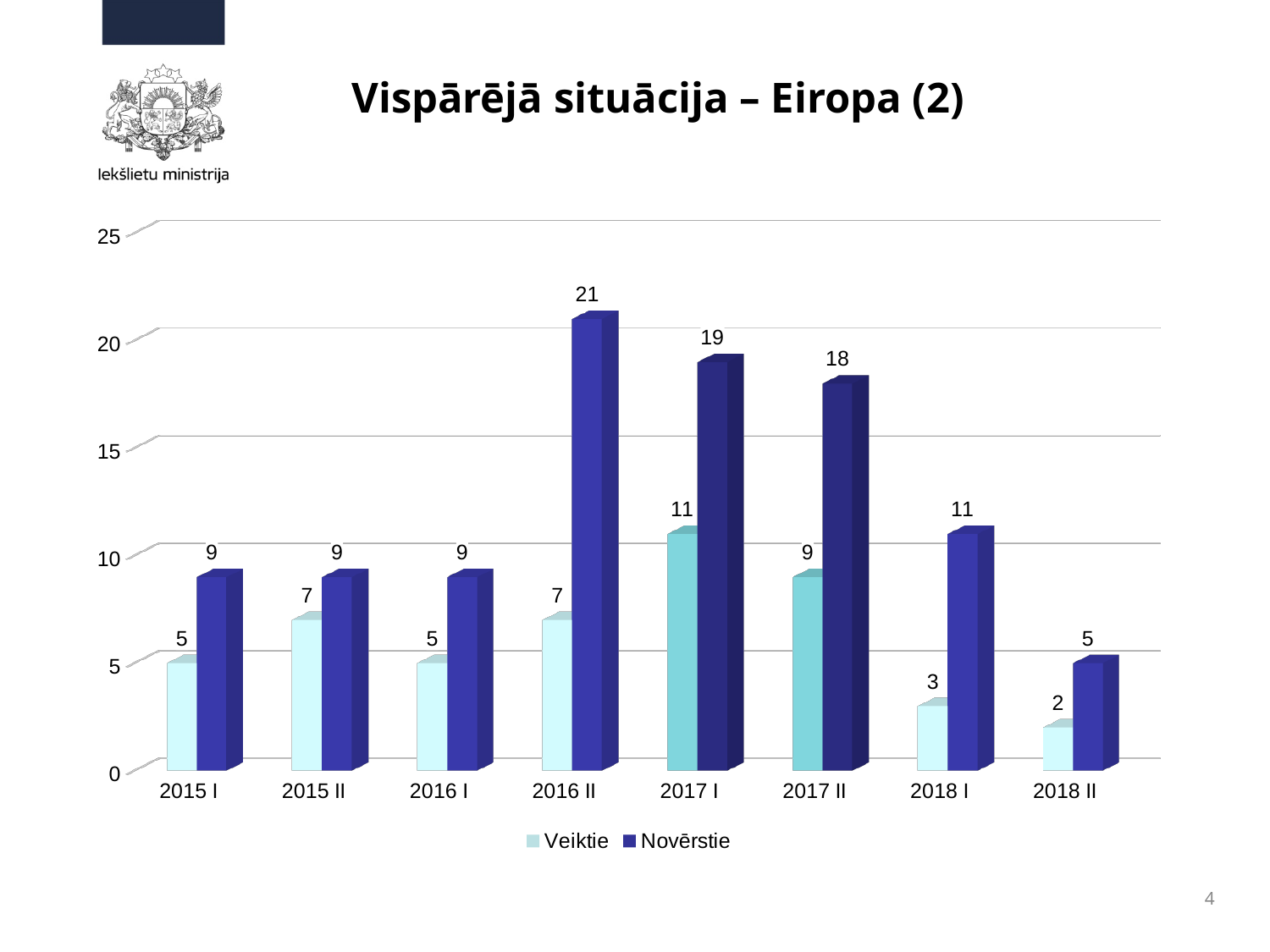
What kind of chart is shown on the slide? bar chart What is the difference between the Novērstie and Veiktie values for 2017 II? 9 Is the Novērstie value for 2017 I greater or less than 15? greater Which period has the highest Novērstie value? 2016 II What is the Novērstie value for 2016 II? 21 What is the Veiktie value for 2018 II? 2 How many periods are shown on the x axis? 8 Which period has the lowest Veiktie value? 2018 II How many series does the legend list? 2 Which is larger: the Novērstie value for 2017 I or the Novērstie value for 2018 I? 2017 I What is the Veiktie value for 2017 I? 11 What are the two series named in the legend? Veiktie and Novērstie